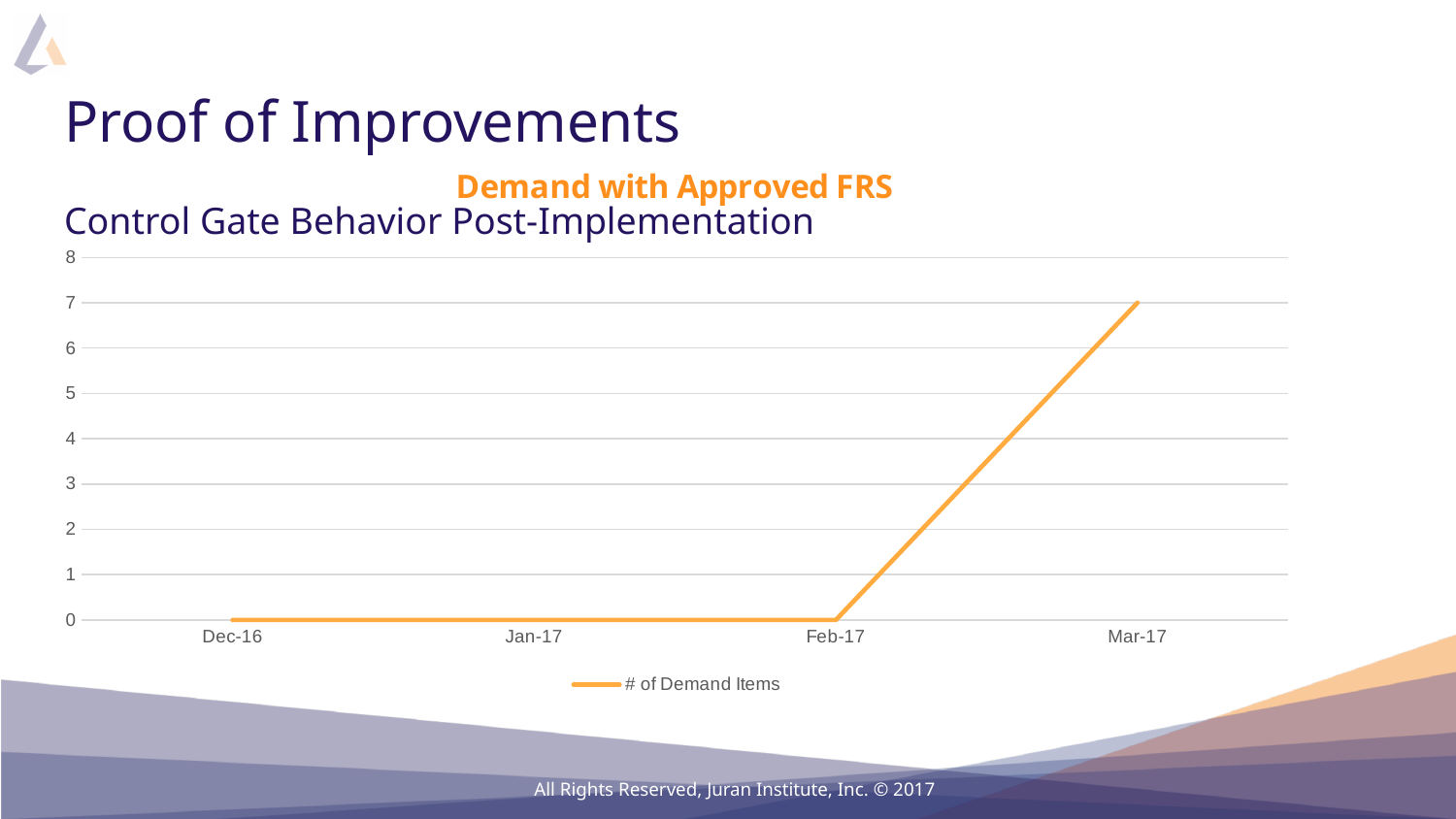
What is the value for Dec-16? 0 What is the value for Feb-17? 0 What is the value for Mar-17? 7 How many points are plotted along the x axis? 4 Which is larger, the value for Mar-17 or the value for Jan-17? Mar-17 What is the title of the chart? Demand with Approved FRS Which month has the highest value? Mar-17 What kind of chart is shown on the slide? line chart What is the difference between the values for Mar-17 and Feb-17? 7 How many series does the legend list? 1 What series does the legend list? # of Demand Items Is the value for Mar-17 greater or less than 5? greater